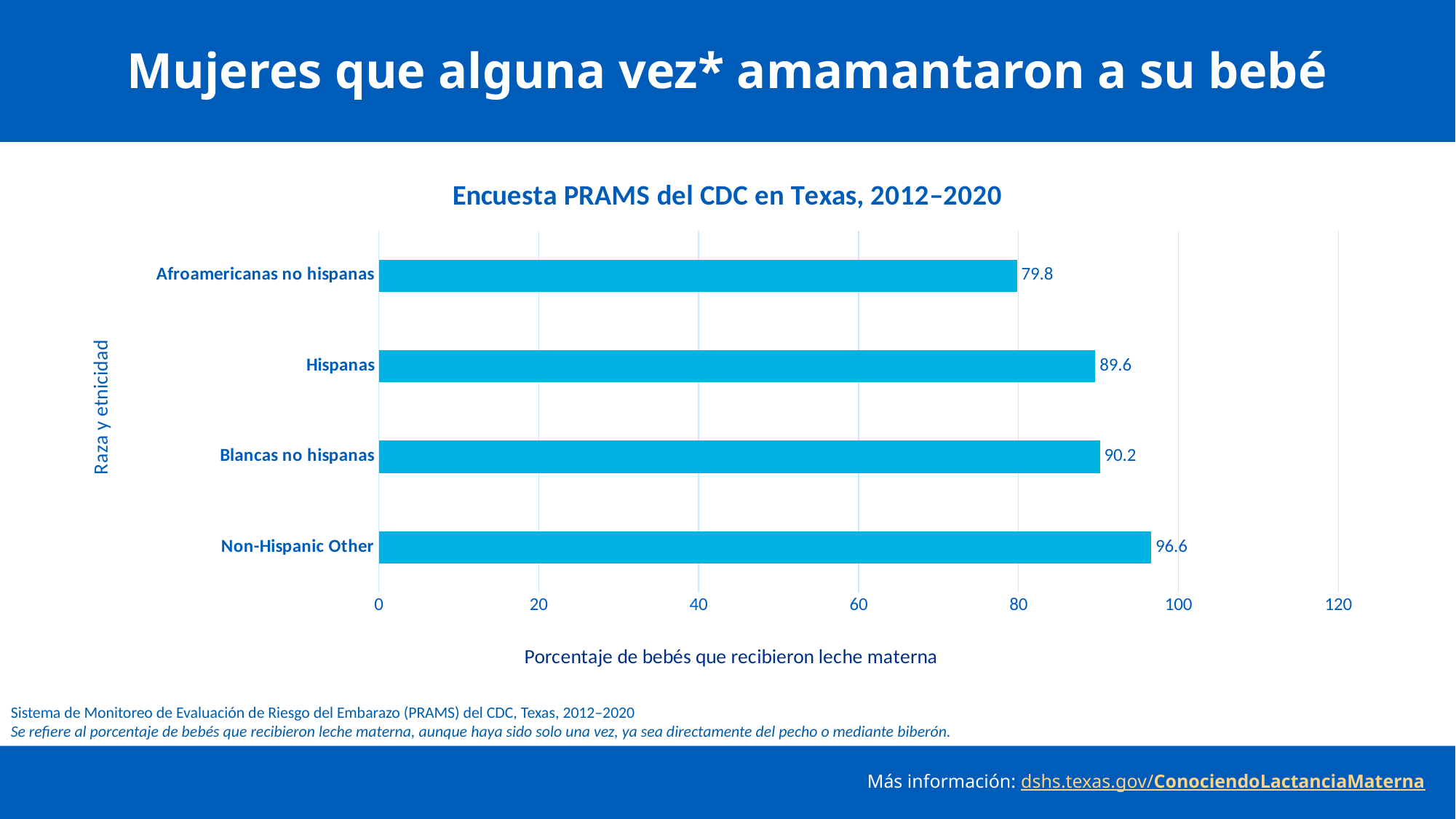
Which is larger, the value for Hispanas or the value for Afroamericanas no hispanas? Hispanas Is the value for Afroamericanas no hispanas greater or less than 80? less Which category has the highest value? Non-Hispanic Other What is the difference between the values for Non-Hispanic Other and Afroamericanas no hispanas? 16.8 What is the value for Non-Hispanic Other? 96.6 How many categories are shown in the chart? 4 What kind of chart is shown on the slide? bar chart What is the value for Hispanas? 89.6 What is the value for Blancas no hispanas? 90.2 What is the title of the chart? Encuesta PRAMS del CDC en Texas, 2012–2020 What is the value for Afroamericanas no hispanas? 79.8 Which category has the lowest value? Afroamericanas no hispanas